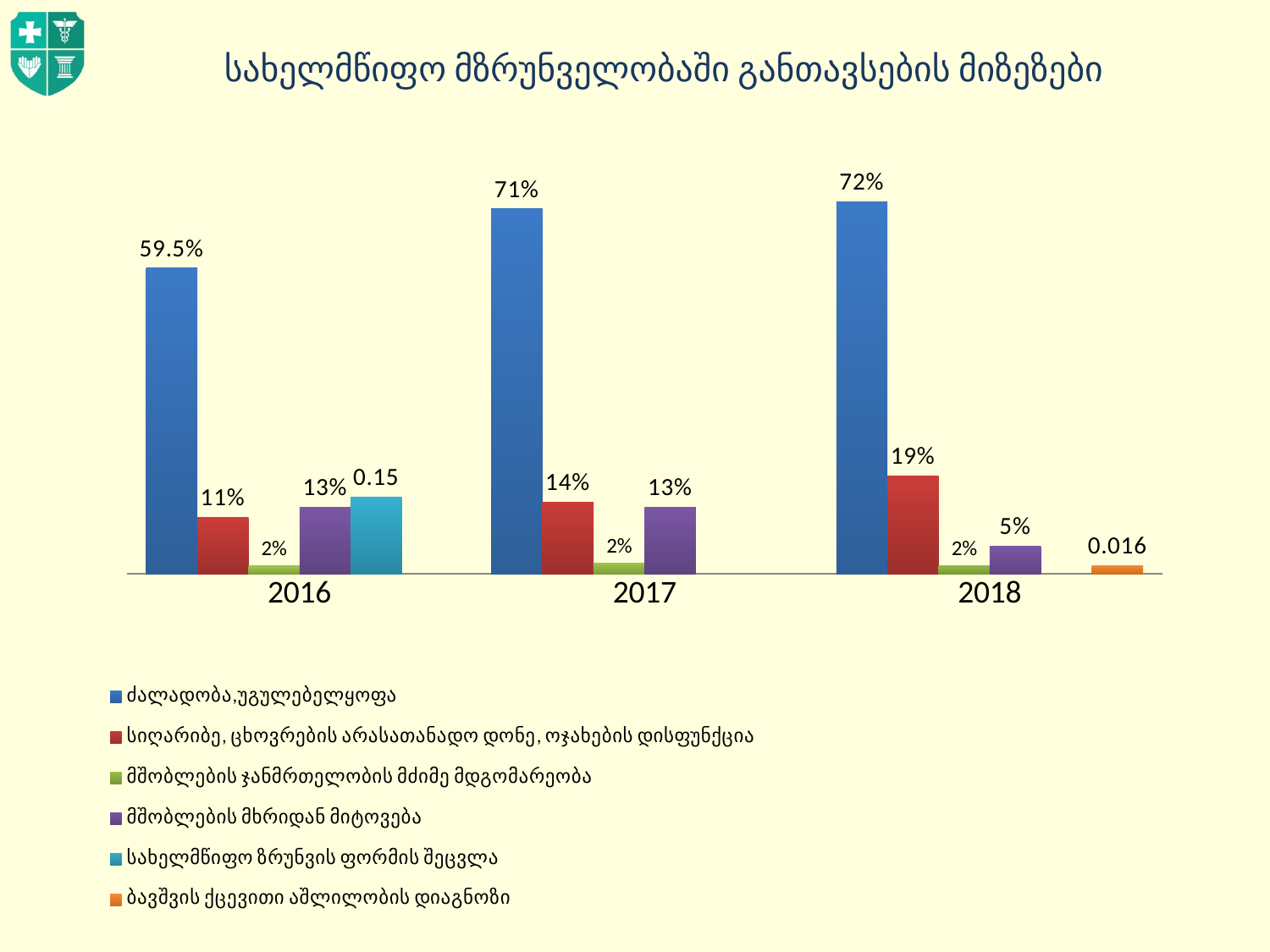
How many years are shown on the x axis? 3 In which year is the red series (სიღარიბე, ცხოვრების არასათანადო დონე, ოჯახების დისფუნქცია) lowest? 2016 What is the value of the red series (სიღარიბე, ცხოვრების არასათანადო დონე, ოჯახების დისფუნქცია) for 2017? 14% Which is larger in 2018: the red series (სიღარიბე...) or the purple series (მშობლების მხრიდან მიტოვება)? the red series (სიღარიბე...) What kind of chart is shown on the slide? bar chart In which year is the blue series (ძალადობა,უგულებელყოფა) highest? 2018 What is the value of the orange series (ბავშვის ქცევითი აშლილობის დიაგნოზი) for 2018? 0.016 How many series does the legend list? 6 What is the value of the blue series (ძალადობა,უგულებელყოფა) for 2016? 59.5% What is the value of the blue series (ძალადობა,უგულებელყოფა) for 2018? 72% What is the difference between the blue series values for 2017 and 2016? 11.5% What is the value of the purple series (მშობლების მხრიდან მიტოვება) for 2018? 5%